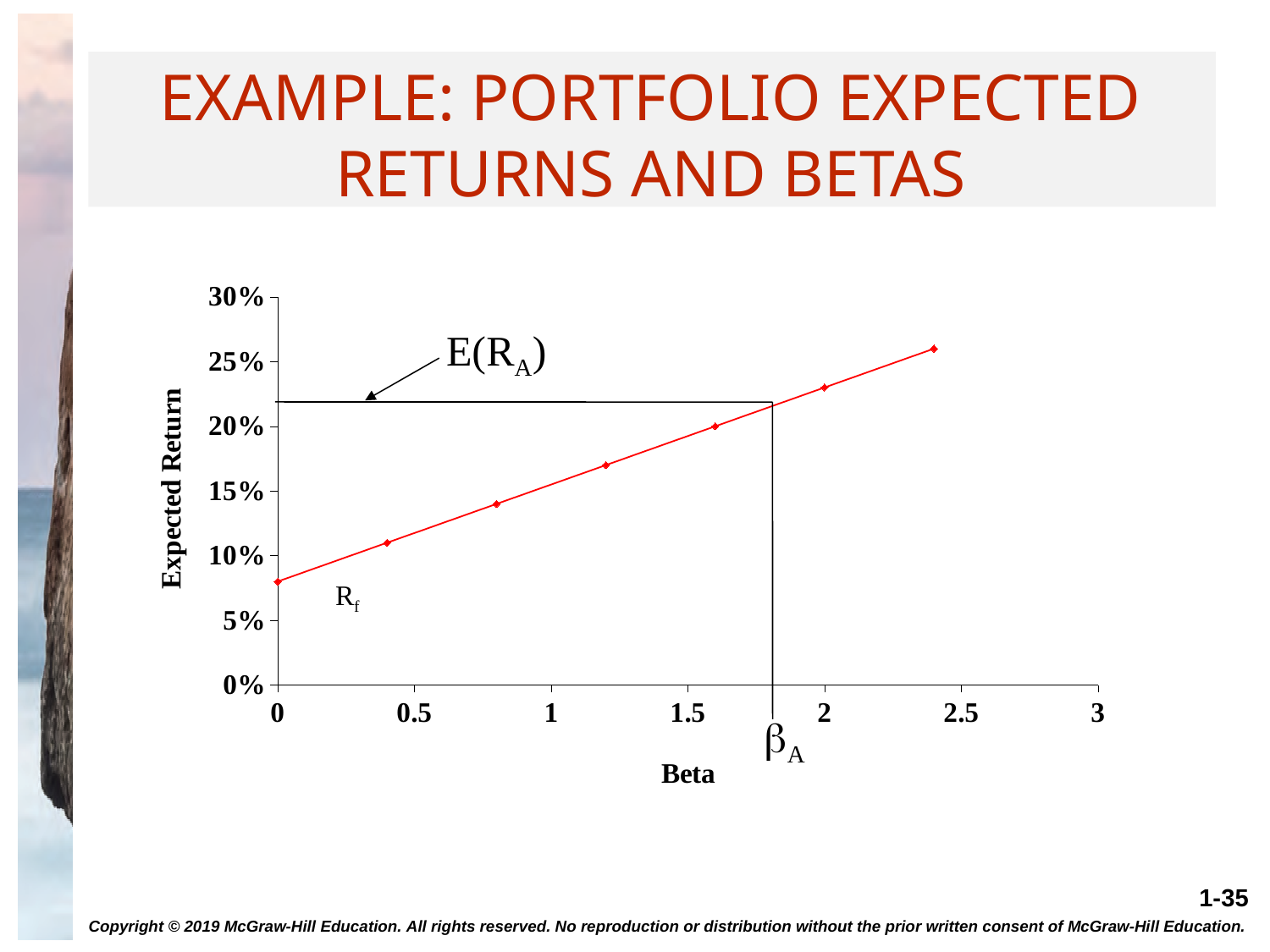
Is the expected return at a beta of 2.4 greater or less than 25%? greater What is the label on the vertical axis of the chart? Expected Return Is the expected return at a beta of 2 greater or less than 20%? greater What kind of chart is shown on the slide? line chart Does the expected return rise or fall as beta increases along the x axis? rise Is the expected return at a beta of 1.2 greater or less than 15%? greater Which has the larger expected return: a beta of 0.4 or a beta of 2? a beta of 2 At which beta value is the expected return lowest? 0 How many data points are plotted on the line? 7 What is the label on the horizontal axis of the chart? Beta